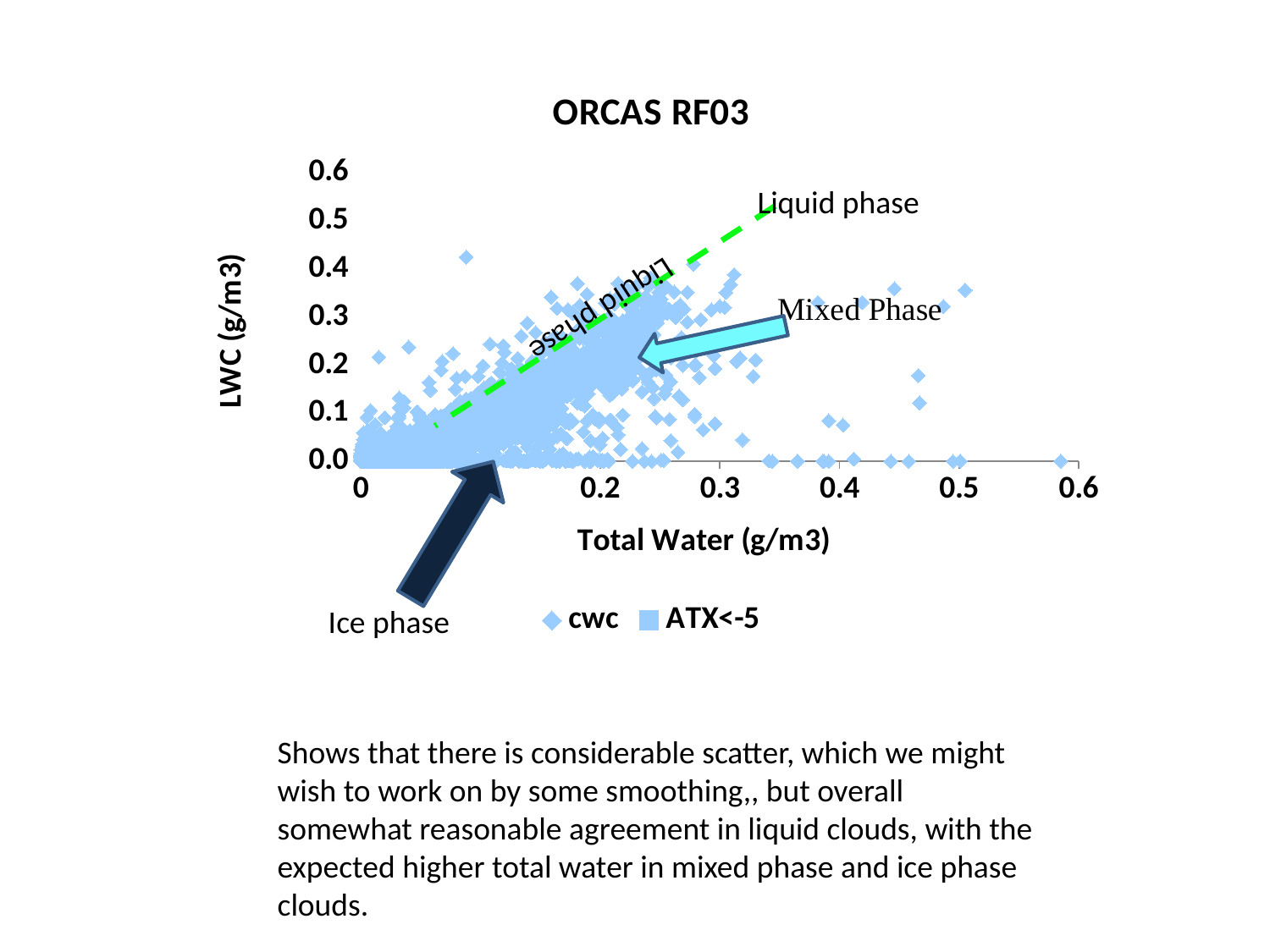
What kind of chart is shown on the slide? scatter chart How many series does the legend list? 2 What are the two series named in the legend? cwc and ATX<-5 What is the title of the chart? ORCAS RF03 Is the highest LWC value plotted on the chart greater or less than 0.5? less Is the largest Total Water value plotted on the chart greater or less than 0.5? greater